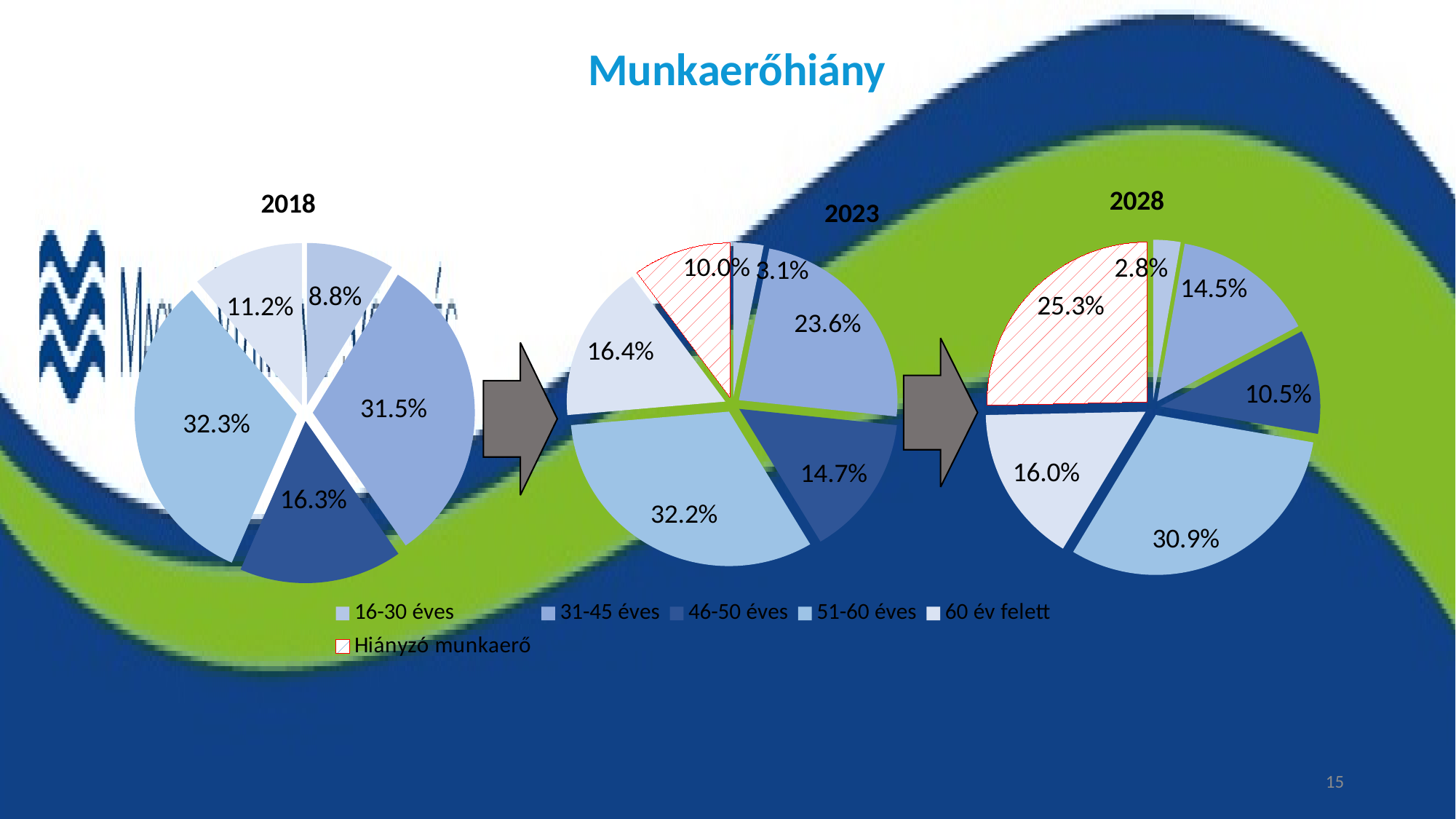
How many slices does the 2018 pie chart have? 5 In the 2018 pie chart, what share is shown for the 31-45 éves group? 31.5% What type of chart is used for the 2018, 2023 and 2028 data? Pie chart In the 2023 pie chart, which is larger: the 31-45 éves slice or the 46-50 éves slice? 31-45 éves In the 2023 pie chart, what share is shown for Hiányzó munkaerő? 10.0% In the 2028 pie chart, which slice is the largest? 51-60 éves (30.9%) In the 2023 pie chart, which slice is the smallest? 16-30 éves (3.1%) In the 2018 pie chart, which slice is the largest? 51-60 éves (32.3%) In the 2028 pie chart, what share is shown for the 46-50 éves group? 10.5% In the 2028 pie chart, what share is shown for Hiányzó munkaerő? 25.3% How many entries does the legend list? 6 What is the difference between the Hiányzó munkaerő share in the 2028 pie chart and in the 2023 pie chart? 15.3 percentage points